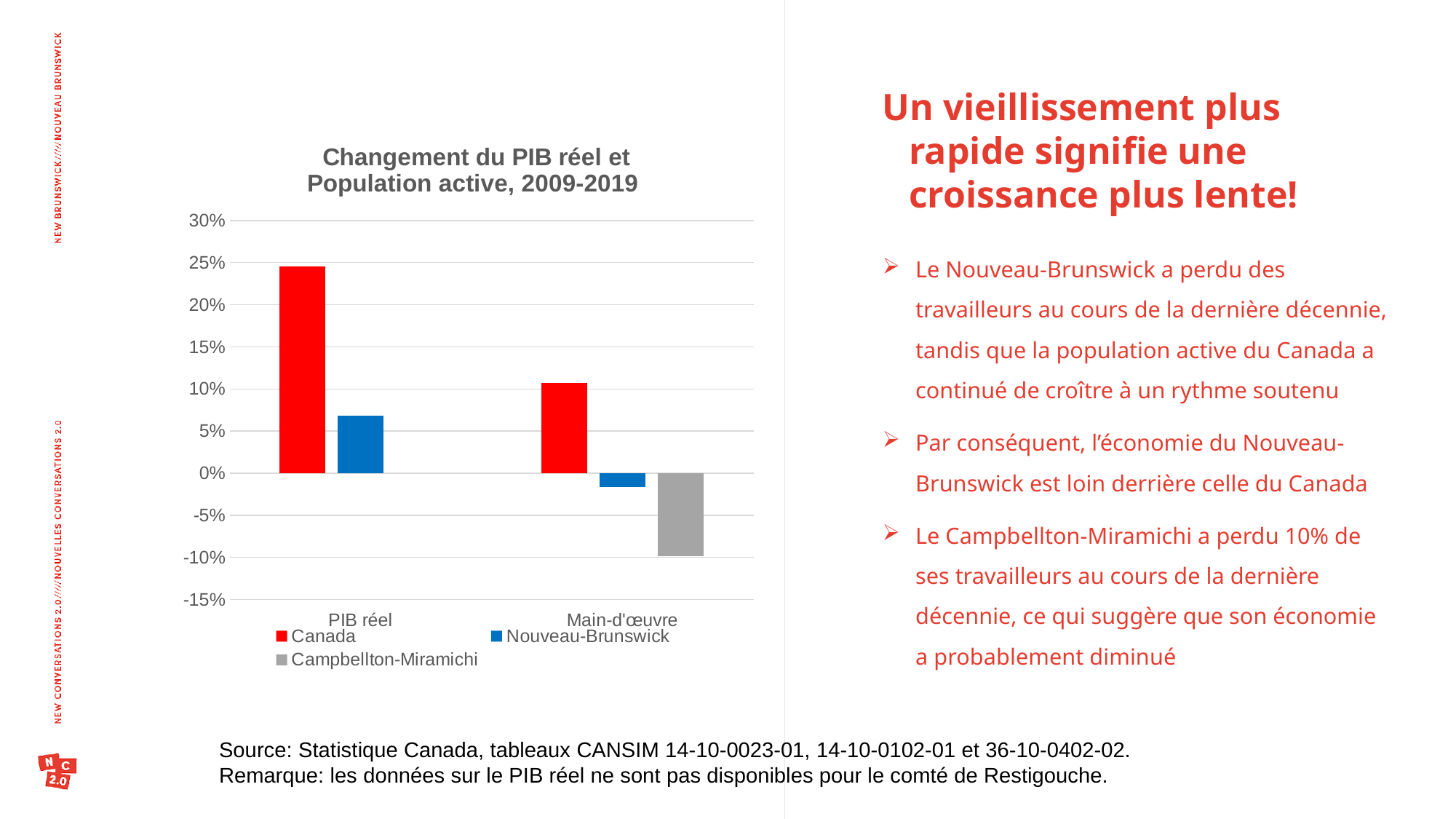
Is the value for Nouveau-Brunswick in the Main-d'œuvre category greater or less than 0%? less Which series has the highest value in the PIB réel category? Canada Is the value for Canada in the Main-d'œuvre category greater or less than 15%? less Which series is shown in red in the chart? Canada In the Main-d'œuvre category, which is larger: the value for Canada or the value for Nouveau-Brunswick? Canada What is the title of the chart? Changement du PIB réel et Population active, 2009-2019 What kind of chart is shown on the slide? bar chart How many categories are shown on the x axis of the chart? 2 Is the value for Nouveau-Brunswick in the PIB réel category greater or less than 5%? greater How many series does the chart legend list? 3